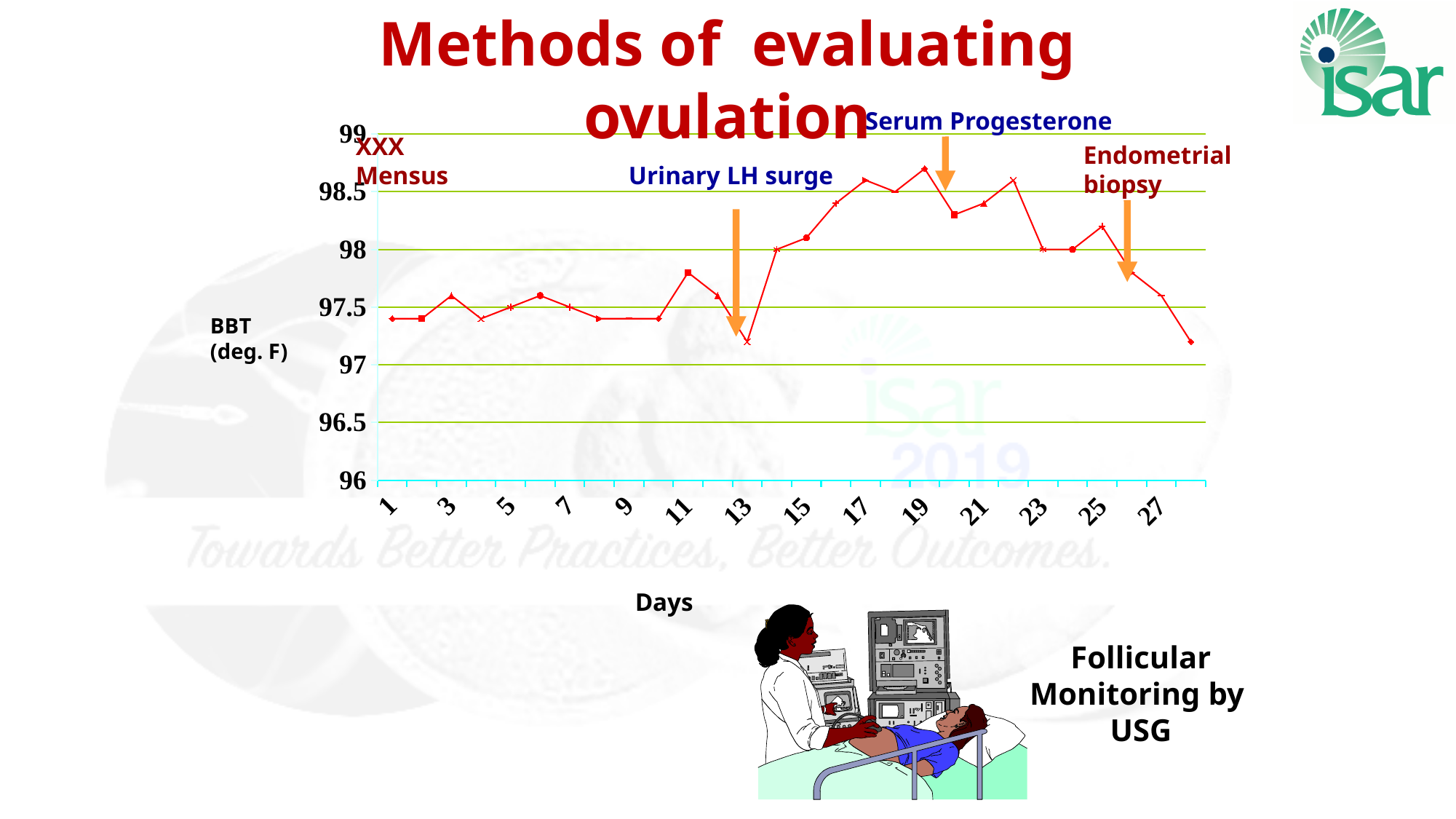
What kind of chart is shown on the slide? line chart Does the BBT value rise or fall from day 13 to day 19? rise Is the BBT value on day 28 greater or less than 97.5? less Which day has the higher BBT value, day 13 or day 14? day 14 Is the BBT value on day 17 greater or less than 98? greater Is the BBT value on day 13 greater or less than 97.5? less Which day has the higher BBT value, day 1 or day 19? day 19 Does the BBT value rise or fall from day 25 to day 28? fall What is the label of the vertical axis of the chart? BBT (deg. F) What is the label of the horizontal axis of the chart? Days